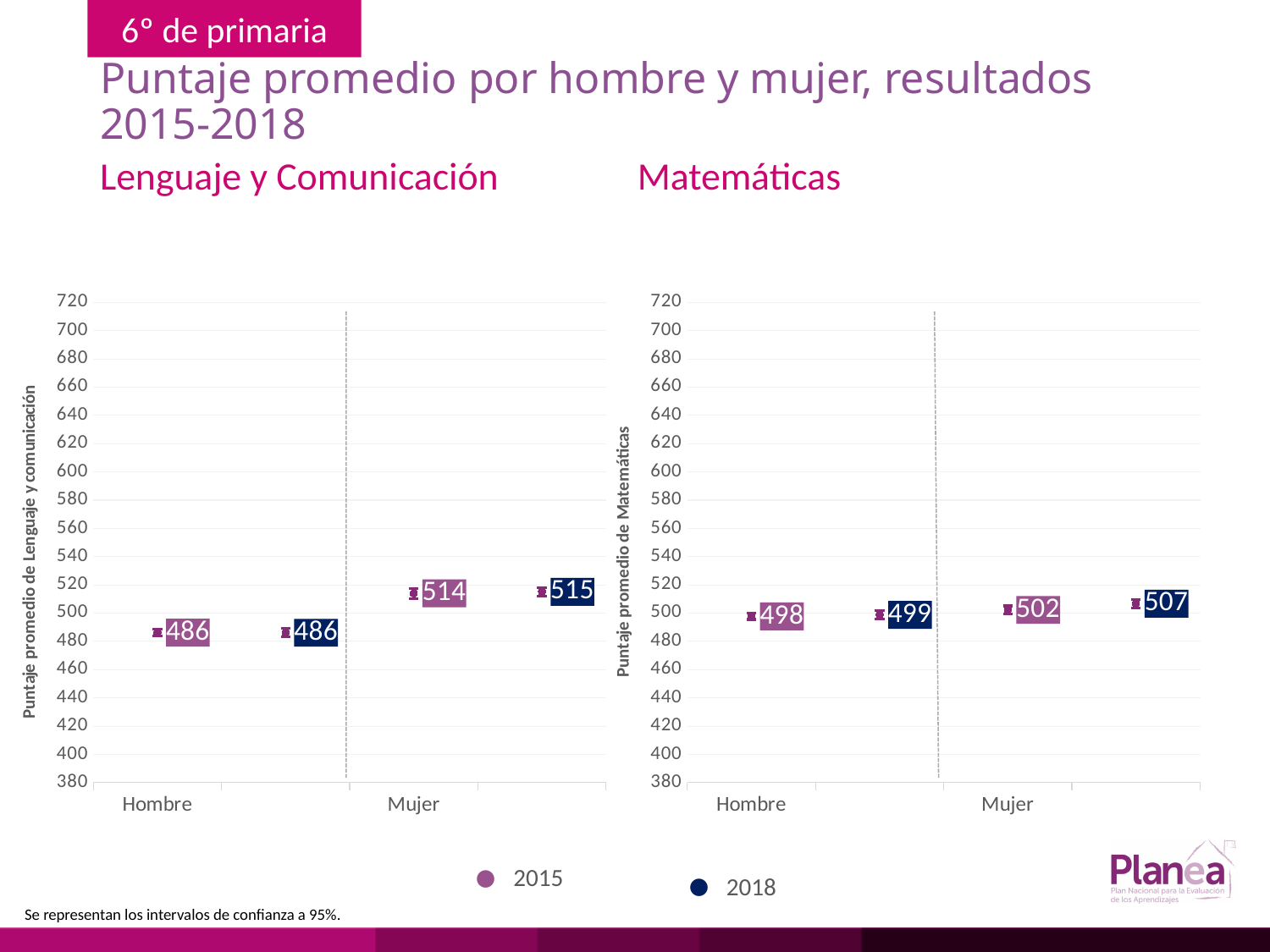
In the Matemáticas chart, what is the difference between the 2018 values for Mujer and Hombre? 8 What is the y-axis title of the Matemáticas chart? Puntaje promedio de Matemáticas In the Lenguaje y Comunicación chart, which category has the highest 2018 value? Mujer In the Matemáticas chart, which category has the lowest 2015 value? Hombre How many series does the legend list? 2 In the Lenguaje y Comunicación chart, what is the 2018 value for Mujer? 515 In the Matemáticas chart, what is the 2018 value for Mujer? 507 In the Lenguaje y Comunicación chart, what is the 2015 value for Hombre? 486 In the Matemáticas chart, what is the 2015 value for Hombre? 498 In the Lenguaje y Comunicación chart, what is the difference between the 2015 values for Mujer and Hombre? 28 How many categories are shown on the x axis of the Matemáticas chart? 2 In the Matemáticas chart, is the 2015 value for Mujer larger or smaller than the 2018 value for Mujer? smaller